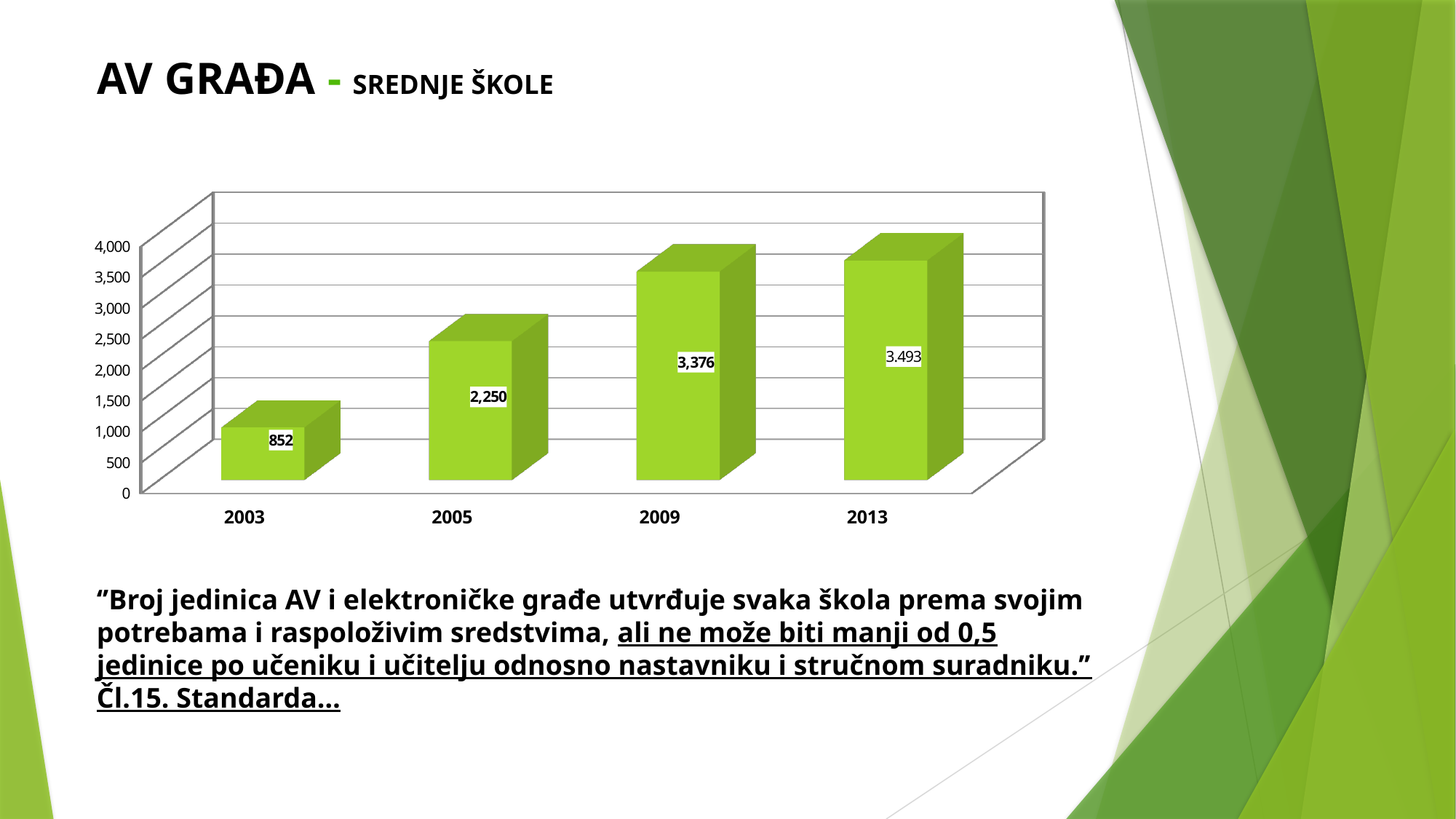
What is the value for 2013? 3.493 Which year has the lowest value? 2003 What is the value for 2009? 3,376 What is the difference between the values for 2009 and 2005? 1,126 What is the value for 2005? 2,250 What is the value for 2003? 852 Which is larger, the value for 2005 or the value for 2009? 2009 How many years are shown on the x axis? 4 Which year has the highest value? 2013 What kind of chart is shown on the slide? bar chart What is the difference between the values for 2005 and 2003? 1,398 Is the value for 2003 greater or less than 1,000? less